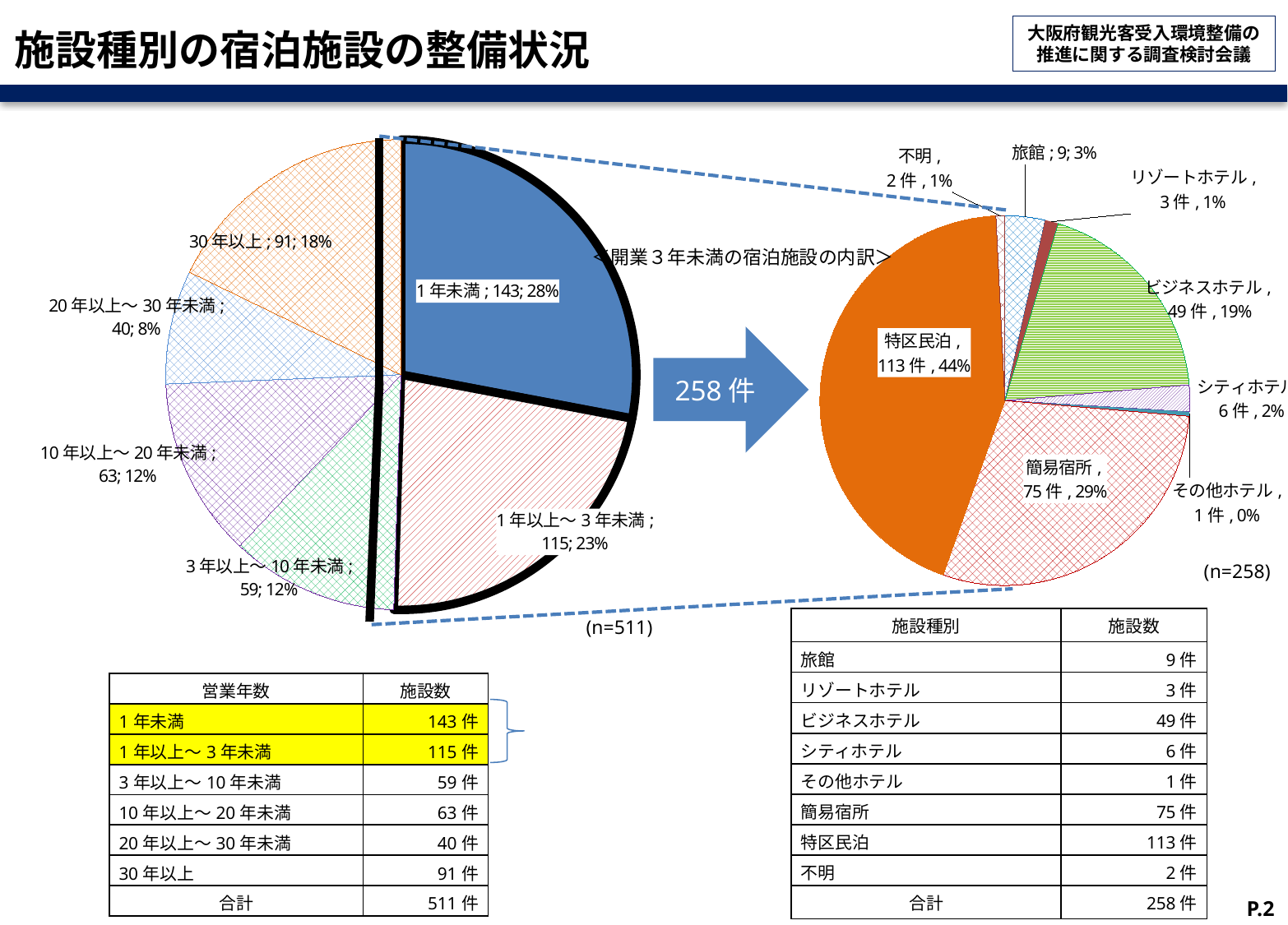
In the left pie chart, what percentage share does 30年以上 have? 18% In the right pie chart, which is larger, 簡易宿所 or ビジネスホテル? 簡易宿所 In the right pie chart, what percentage share does ビジネスホテル have? 19% In the right pie chart, which category has the smallest number of facilities? その他ホテル In the left pie chart, which category has the smallest number of facilities? 20年以上～30年未満 In the right pie chart, how many facilities are 特区民泊? 113件 In the left pie chart, which category has the largest number of facilities? 1年未満 In the left pie chart, how many facilities are in the 1年未満 category? 143 What kind of chart is the left chart on the slide? pie chart In the left pie chart, what is the difference between the 1年未満 and 1年以上～3年未満 values? 28 What is the sample size (n) shown for the right pie chart? n=258 How many categories does the left pie chart show? 6